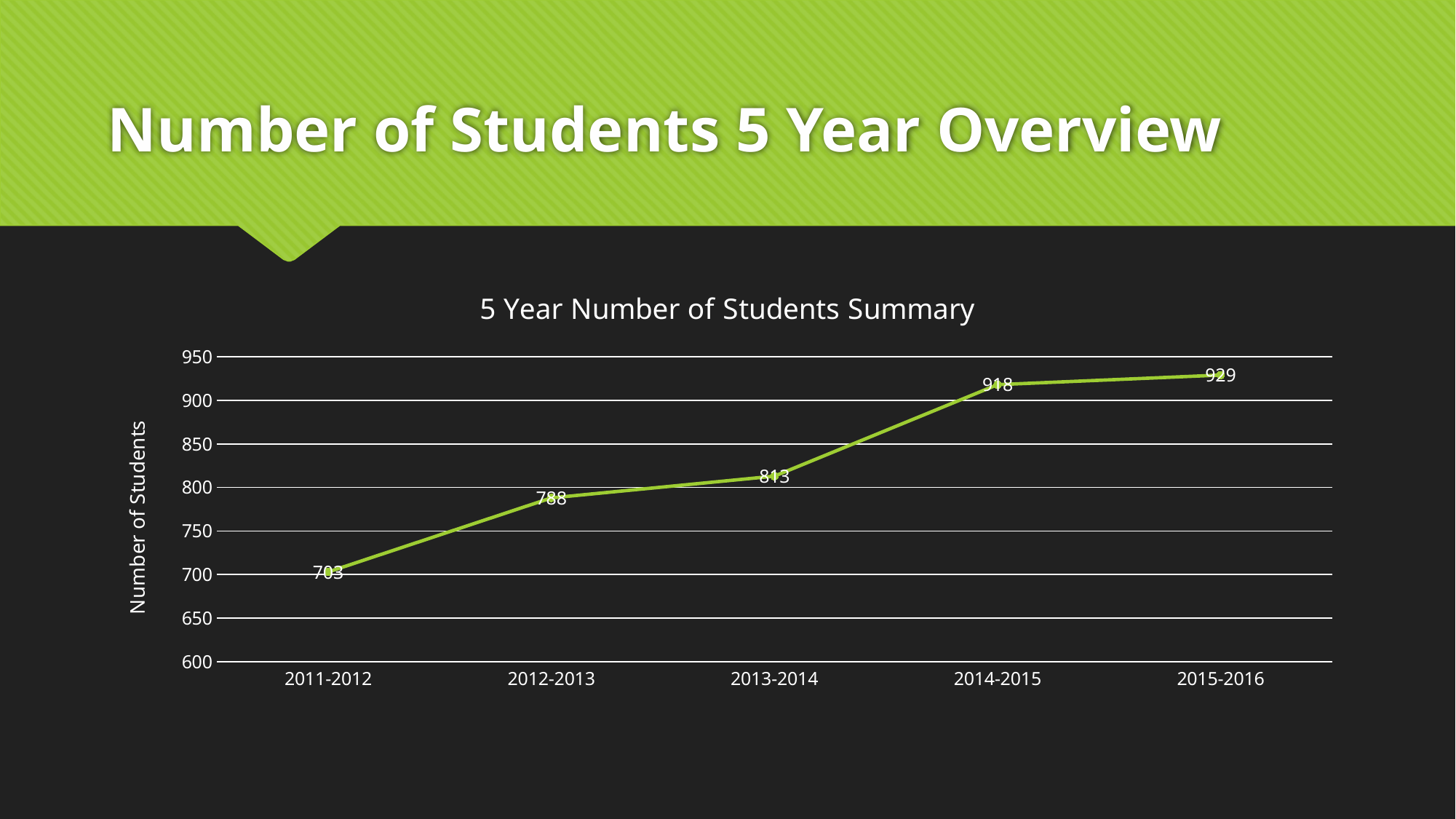
Which year has the highest number of students? 2015-2016 Do the values rise or fall from 2011-2012 to 2015-2016? Rise What is the number of students for 2013-2014? 813 Which year has the lowest number of students? 2011-2012 What is the difference in number of students between 2014-2015 and 2012-2013? 130 Which year has more students, 2012-2013 or 2013-2014? 2013-2014 What is the title of the chart? 5 Year Number of Students Summary What is the number of students for 2011-2012? 703 What is the number of students for 2015-2016? 929 Is the value for 2014-2015 greater or less than 900? greater How many years are plotted on the chart? 5 What kind of chart is shown on the slide? Line chart